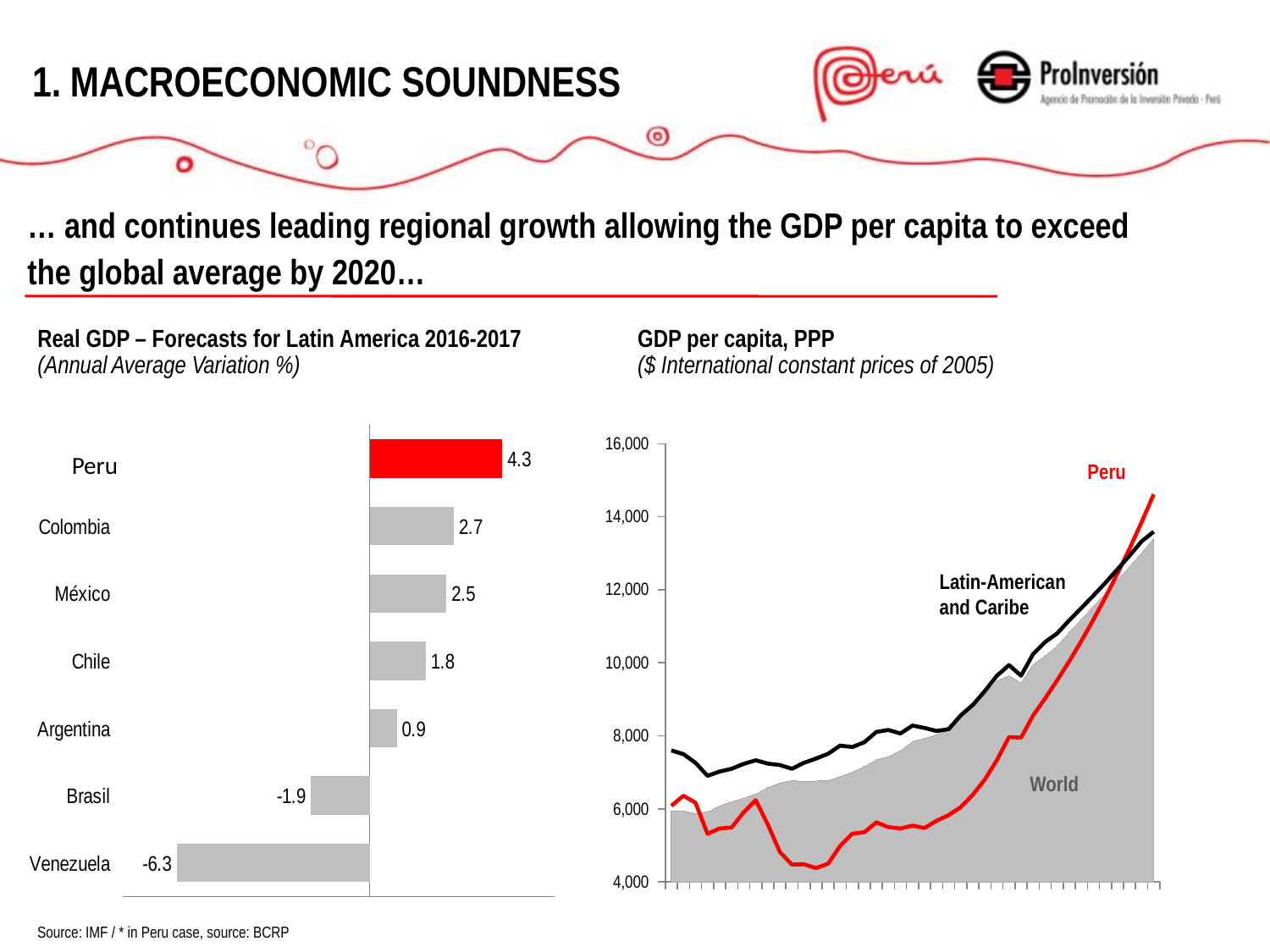
What kind of chart is the Real GDP forecasts chart? Bar chart On the Real GDP forecasts chart, what is the difference between the values for Peru and Colombia? 1.6 How many countries are shown on the Real GDP forecasts chart? 7 On the GDP per capita, PPP chart, how many series are plotted? 3 On the GDP per capita, PPP chart, does the Peru series generally rise or fall from left to right? Rise On the GDP per capita, PPP chart, is the value for Peru at the right end of the chart greater or less than 14,000? greater On the Real GDP forecasts chart, what is the value for Chile? 1.8 On the Real GDP forecasts chart, which country has the lowest value? Venezuela On the Real GDP forecasts chart, which country has the highest value? Peru On the Real GDP forecasts chart, which is larger, the value for México or the value for Argentina? México On the Real GDP forecasts chart, what is the value for Peru? 4.3 On the Real GDP forecasts chart, what is the value for Venezuela? -6.3